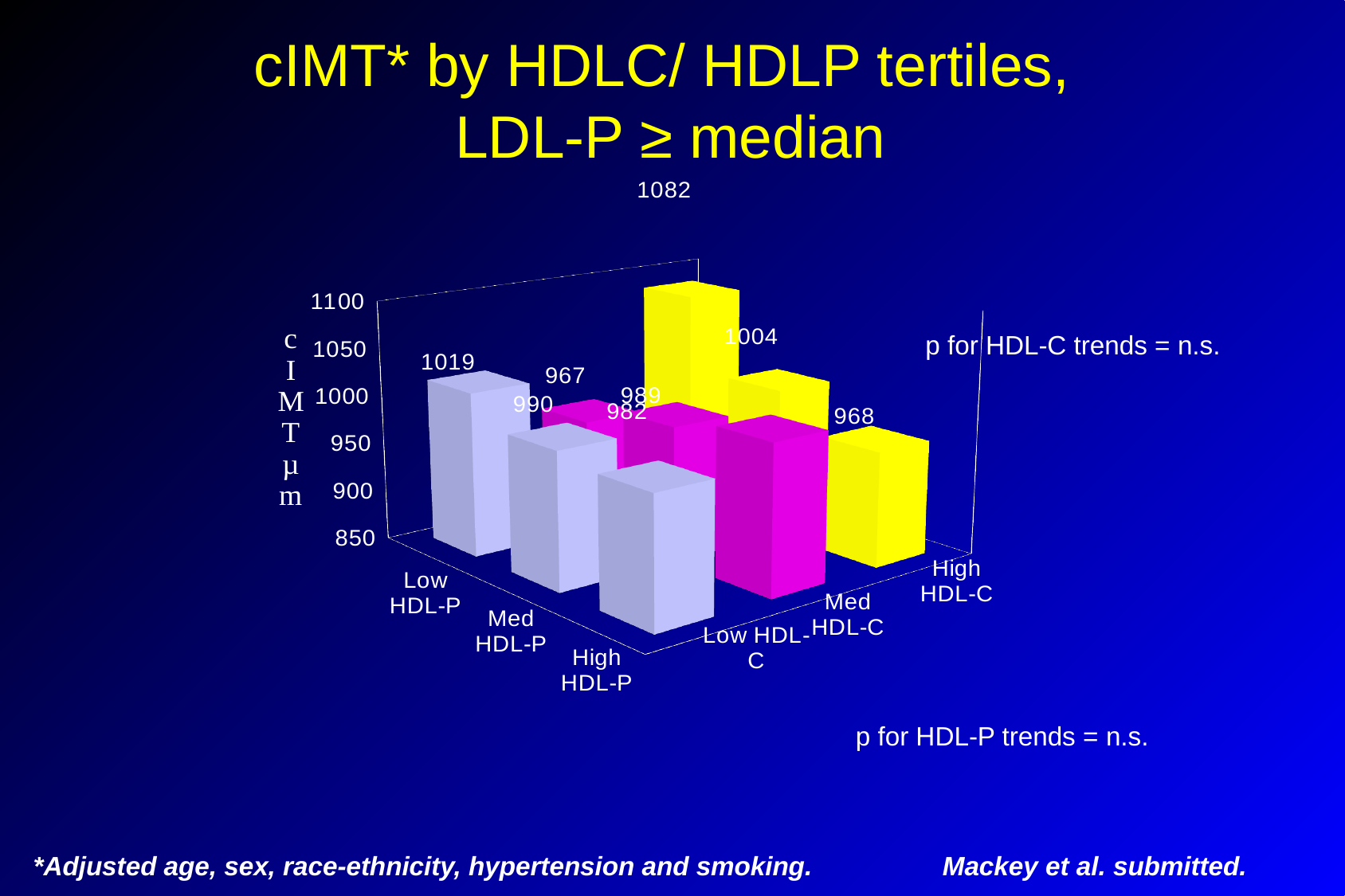
What is the cIMT value for Med HDL-P in the High HDL-C group? 1004 What is the cIMT value for High HDL-P in the High HDL-C group? 968 How many HDL-P tertile categories are shown on the chart? 3 What is the highest cIMT value labelled on the chart? 1082 Which HDL-P / HDL-C combination has the highest cIMT value? Low HDL-P, High HDL-C What kind of chart is shown on the slide? bar chart What is the title of the chart? cIMT* by HDLC/ HDLP tertiles, LDL-P ≥ median What is the cIMT value for Low HDL-P in the Low HDL-C group? 1019 What is the unit shown on the vertical axis label? µm Which is larger: the cIMT value for Low HDL-P in the Low HDL-C group or for High HDL-P in the High HDL-C group? Low HDL-P in the Low HDL-C group How many HDL-C groups (series) are plotted on the chart? 3 What is the difference between the cIMT values for Low HDL-P and High HDL-P in the High HDL-C group? 114